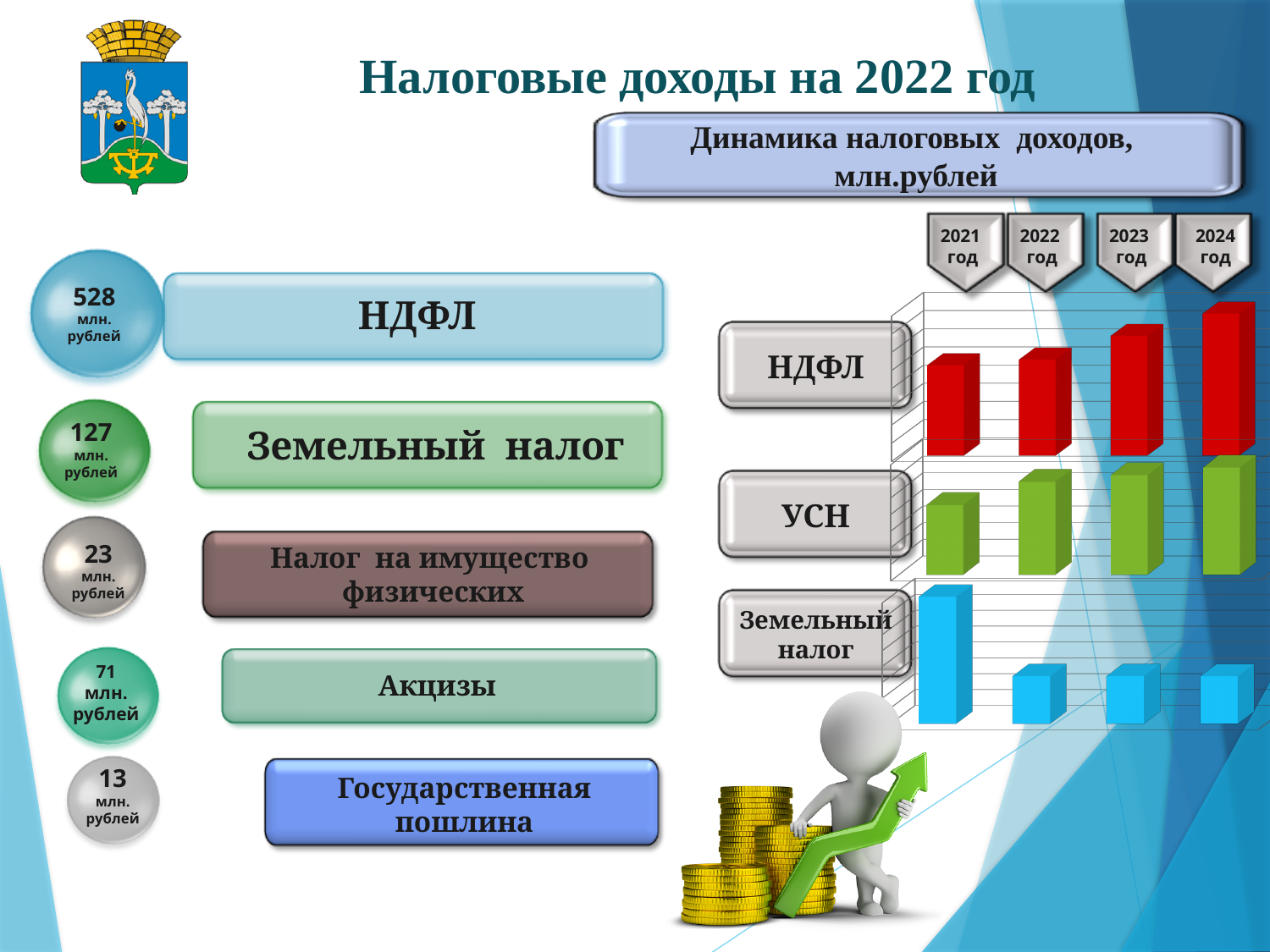
In the chart "Динамика налоговых доходов", is the Земельный налог bar for 2021 larger or smaller than the one for 2022? larger In the chart "Динамика налоговых доходов", is the УСН bar for 2024 larger or smaller than the one for 2021? larger In the chart "Динамика налоговых доходов", do the НДФЛ bars rise or fall from 2021 to 2024? rise In the chart "Динамика налоговых доходов", which year has the highest Земельный налог bar? 2021 год In the chart "Динамика налоговых доходов", which year has the lowest НДФЛ bar? 2021 год Which tax series in the chart "Динамика налоговых доходов" is drawn in red? НДФЛ In the chart "Динамика налоговых доходов", which year has the highest НДФЛ bar? 2024 год In the chart "Динамика налоговых доходов", which year has the lowest УСН bar? 2021 год What is the title of the chart on the right side of the slide? Динамика налоговых доходов, млн.рублей How many tax series (rows) does the chart "Динамика налоговых доходов" show? 3 What kind of chart is shown under the heading "Динамика налоговых доходов, млн.рублей"? bar chart How many years are shown along the top of the chart "Динамика налоговых доходов"? 4